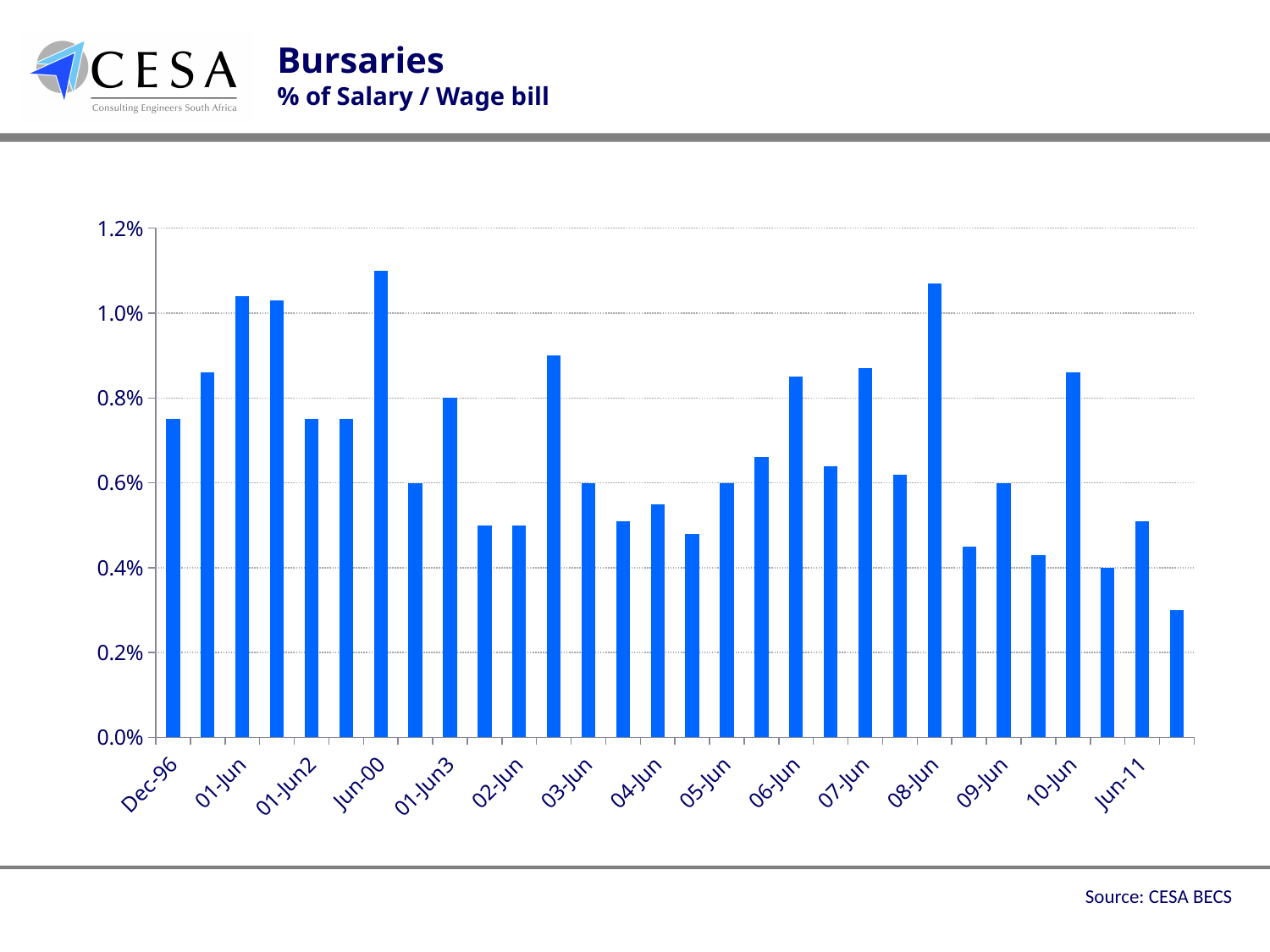
What kind of chart is shown on the slide? Bar chart Is the value for Jun-00 greater or less than 1.0%? greater Which is larger, the value for Dec-96 or the value for 01-Jun? 01-Jun Is the value for 02-Jun greater or less than 0.6%? less Is the value for 01-Jun greater or less than 1.0%? greater Which is larger, the value for Jun-00 or the value for 02-Jun? Jun-00 How many category labels are shown on the x axis? 15 What is the title of the chart on the slide? Bursaries % of Salary / Wage bill What source is cited for the chart? CESA BECS